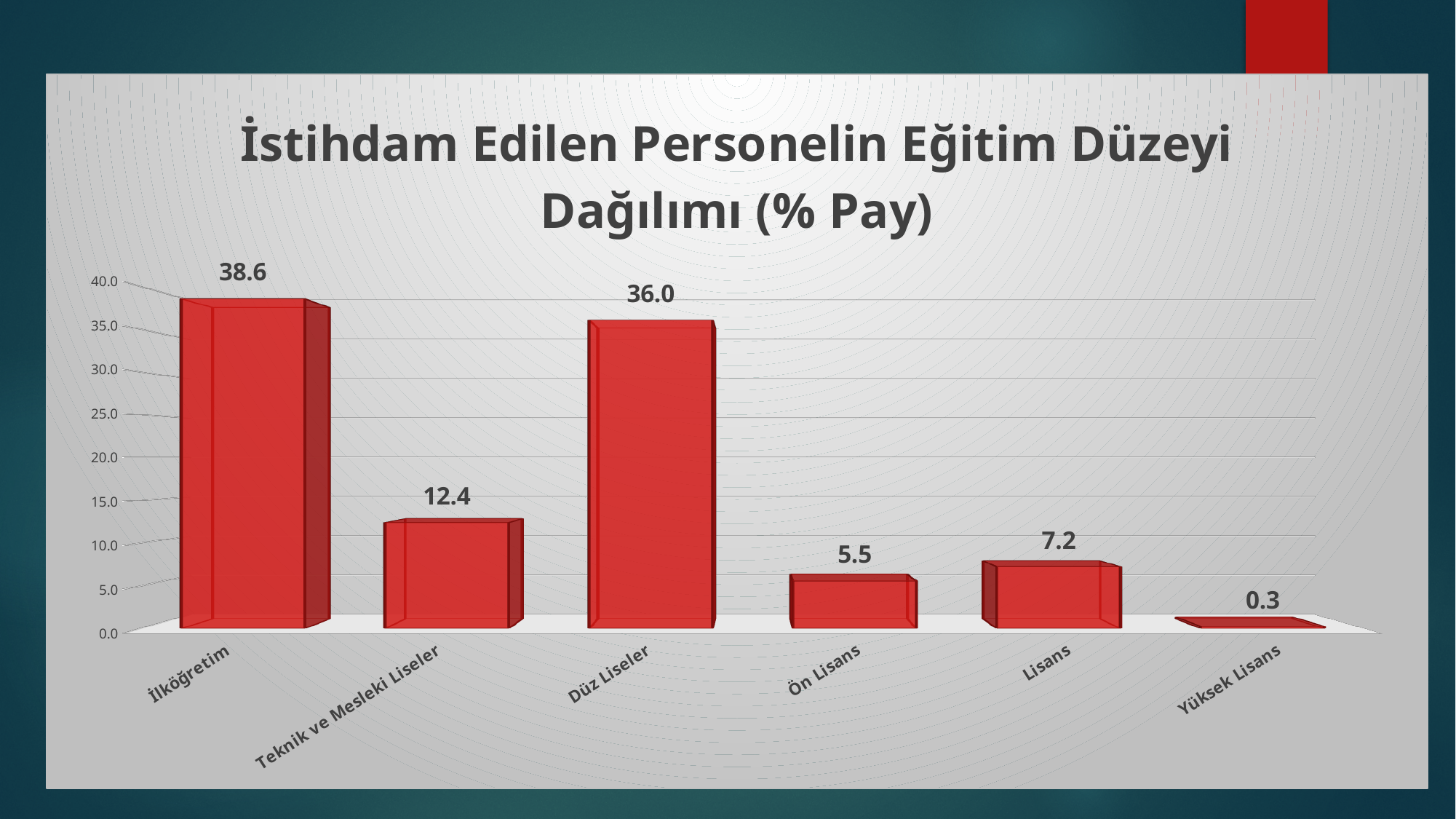
What is the difference between the values for İlköğretim and Düz Liseler? 2.6 What is the value for Teknik ve Mesleki Liseler? 12.4 What kind of chart is shown on the slide? bar chart What is the difference between the values for Lisans and Ön Lisans? 1.7 How many categories are shown on the chart? 6 Which is larger, the value for Lisans or the value for Ön Lisans? Lisans Which category has the highest value? İlköğretim Is the value for Düz Liseler greater or less than 30.0? greater What is the value for İlköğretim? 38.6 Which category has the lowest value? Yüksek Lisans What is the value for Yüksek Lisans? 0.3 What is the title of the chart? İstihdam Edilen Personelin Eğitim Düzeyi Dağılımı (% Pay)